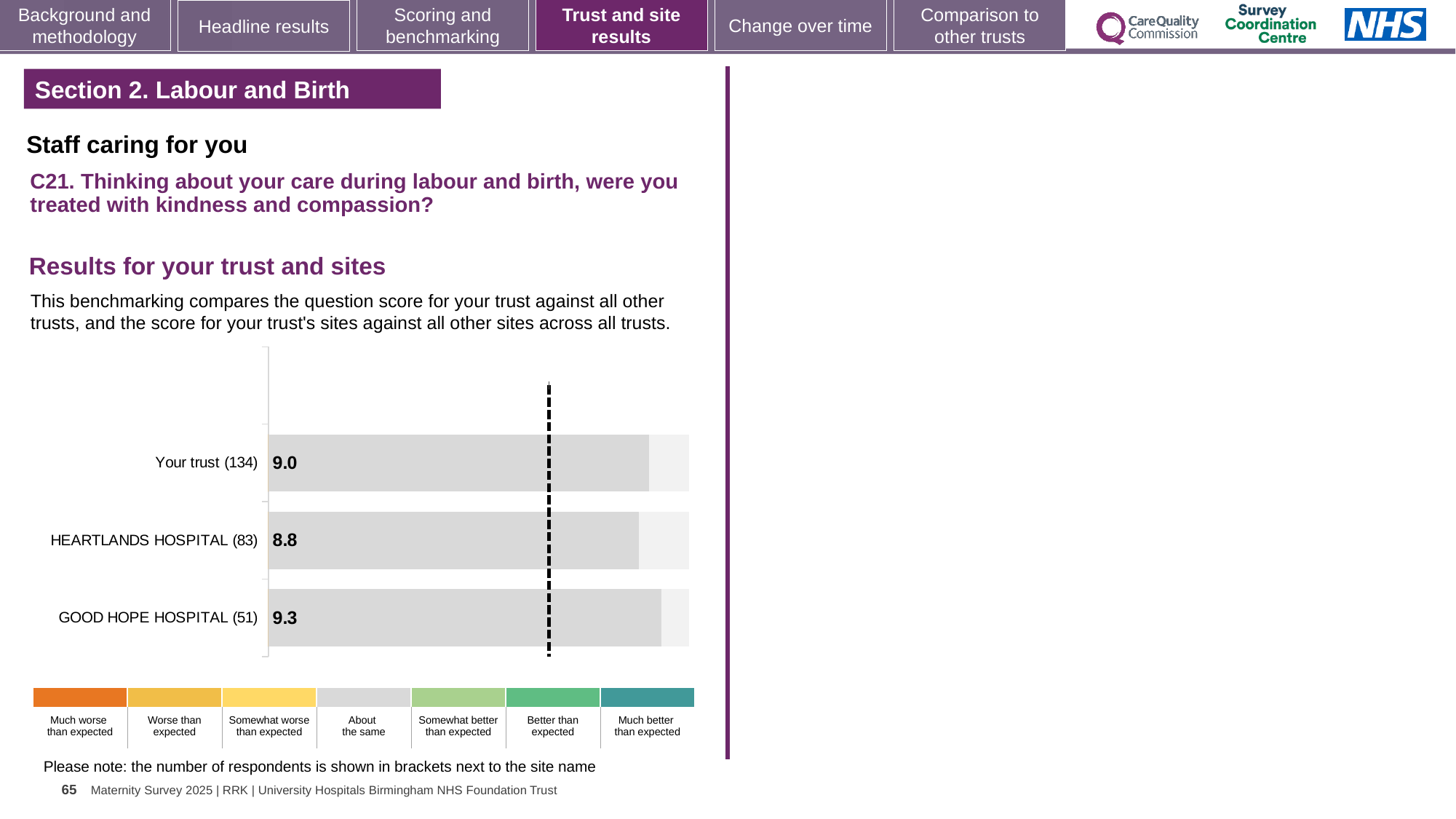
What is the score for HEARTLANDS HOSPITAL? 8.8 What kind of chart is shown on the slide? Bar chart What is the score for Your trust? 9.0 What is the score for GOOD HOPE HOSPITAL? 9.3 How many categories does the colour legend below the chart list? 7 Which site or trust has the highest score? GOOD HOPE HOSPITAL What is the difference between the scores for Your trust and HEARTLANDS HOSPITAL? 0.2 How many bars are shown in the chart? 3 What is the difference between the scores for GOOD HOPE HOSPITAL and HEARTLANDS HOSPITAL? 0.5 How many respondents are shown in brackets for GOOD HOPE HOSPITAL? 51 Which site or trust has the lowest score? HEARTLANDS HOSPITAL Which has a higher score, Your trust or GOOD HOPE HOSPITAL? GOOD HOPE HOSPITAL